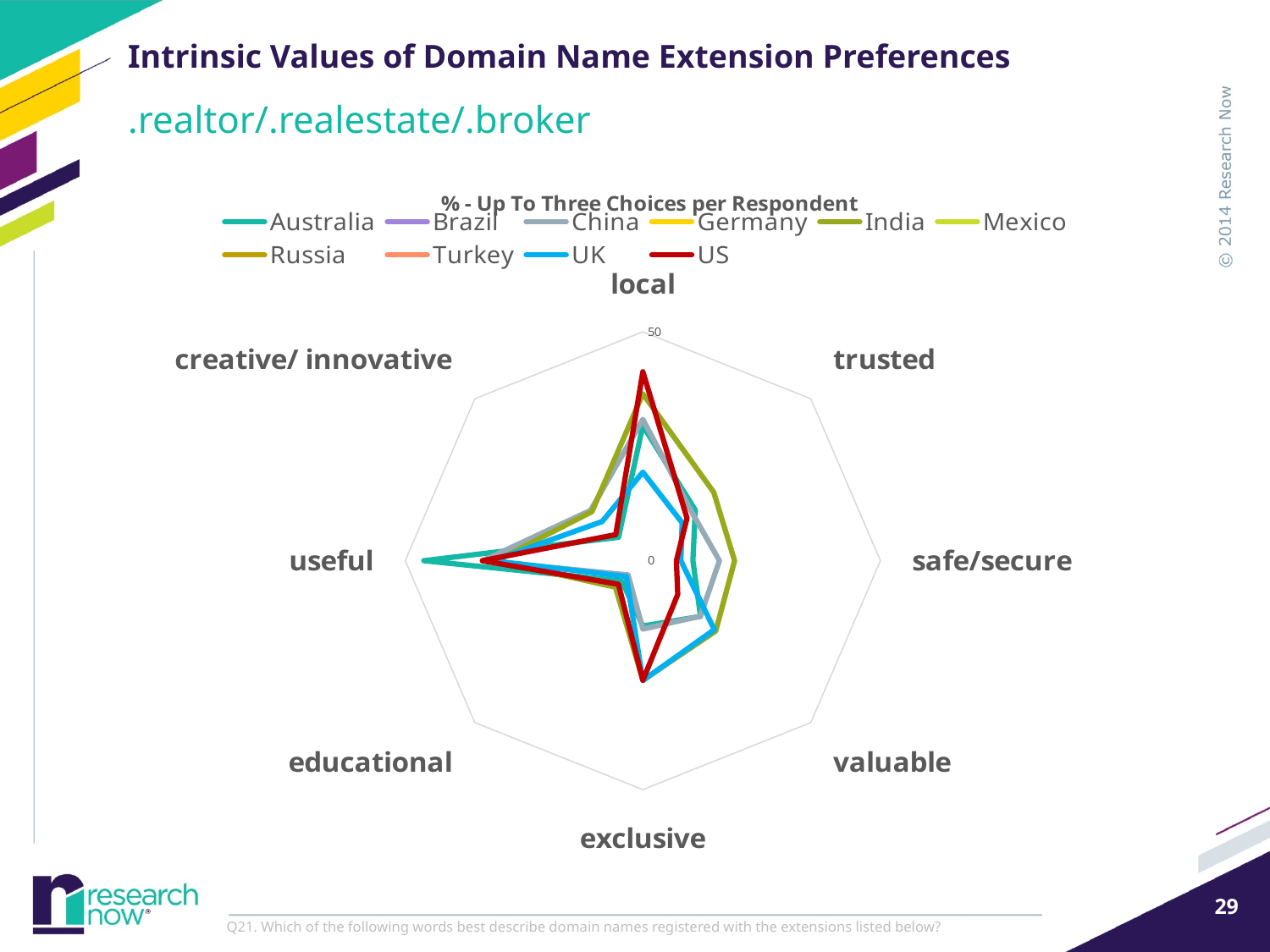
Which category is positioned at the top of the radar chart? local What subtitle appears above the legend of the chart? % - Up To Three Choices per Respondent What kind of chart is shown on the slide? radar chart What is the maximum value shown on the radar chart's axis scale? 50 Which category has the highest value plotted on the radar chart? useful How many series does the legend list? 10 How many categories (axes) does the radar chart have? 8